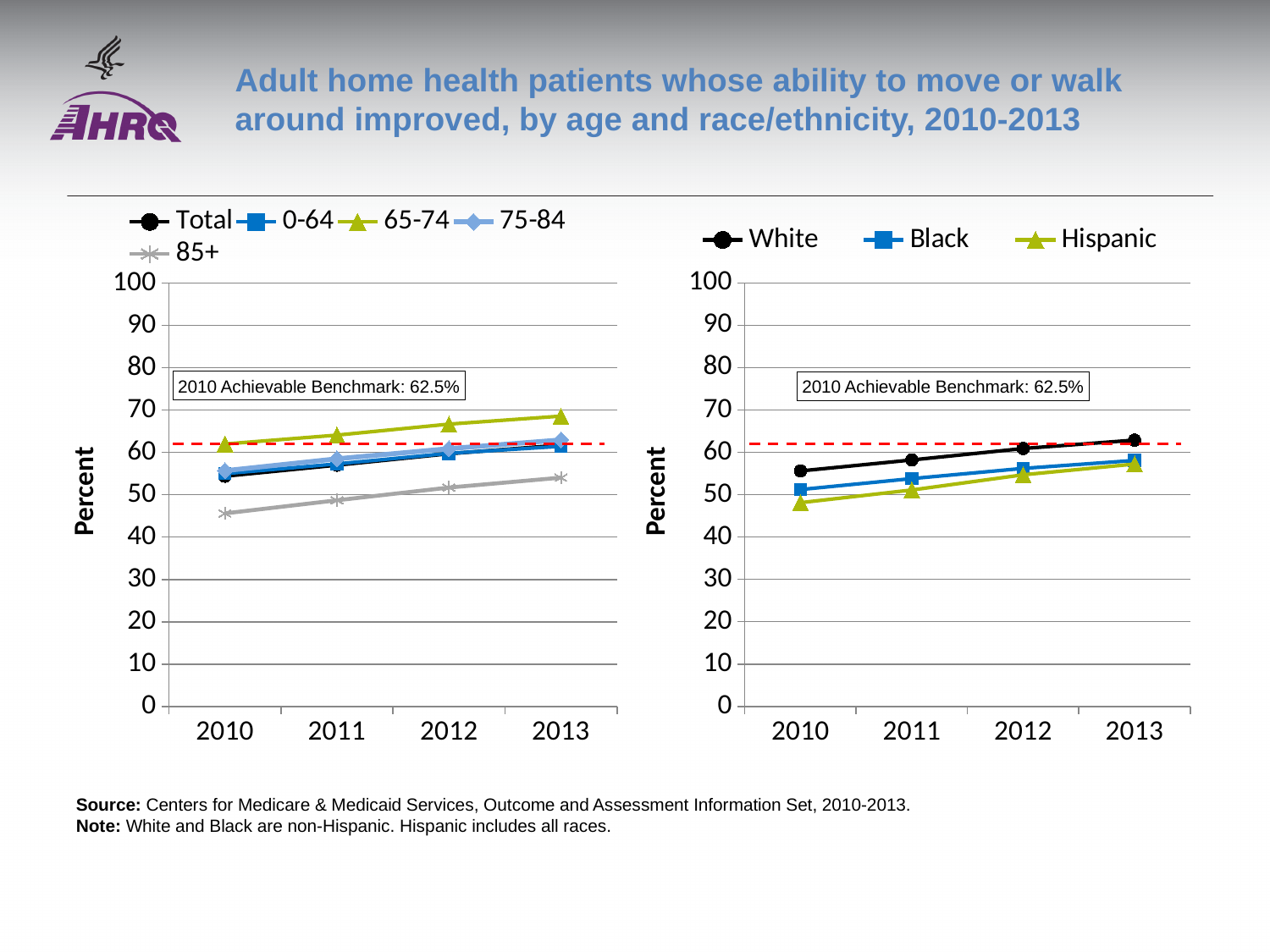
In the right chart (by race/ethnicity), is the value for Hispanic in 2010 greater or less than 50? less In the left chart (by age), is the value for 85+ in 2010 greater or less than 50? less What type of chart is the left chart (by age)? line chart How many series does the legend of the left chart (by age) list? 5 What is the 2010 Achievable Benchmark shown on the charts? 62.5% In the left chart (by age), which age group has the highest value in 2013? 65-74 In the right chart (by race/ethnicity), which group has the highest value in 2010? White In the right chart (by race/ethnicity), does the value for Black rise or fall from 2010 to 2013? rise How many years are shown on the x axis of the right chart (by race/ethnicity)? 4 In the left chart (by age), is the value for 65-74 in 2013 greater or less than 60? greater How many series does the legend of the right chart (by race/ethnicity) list? 3 In the left chart (by age), which age group has the lowest value in 2010? 85+